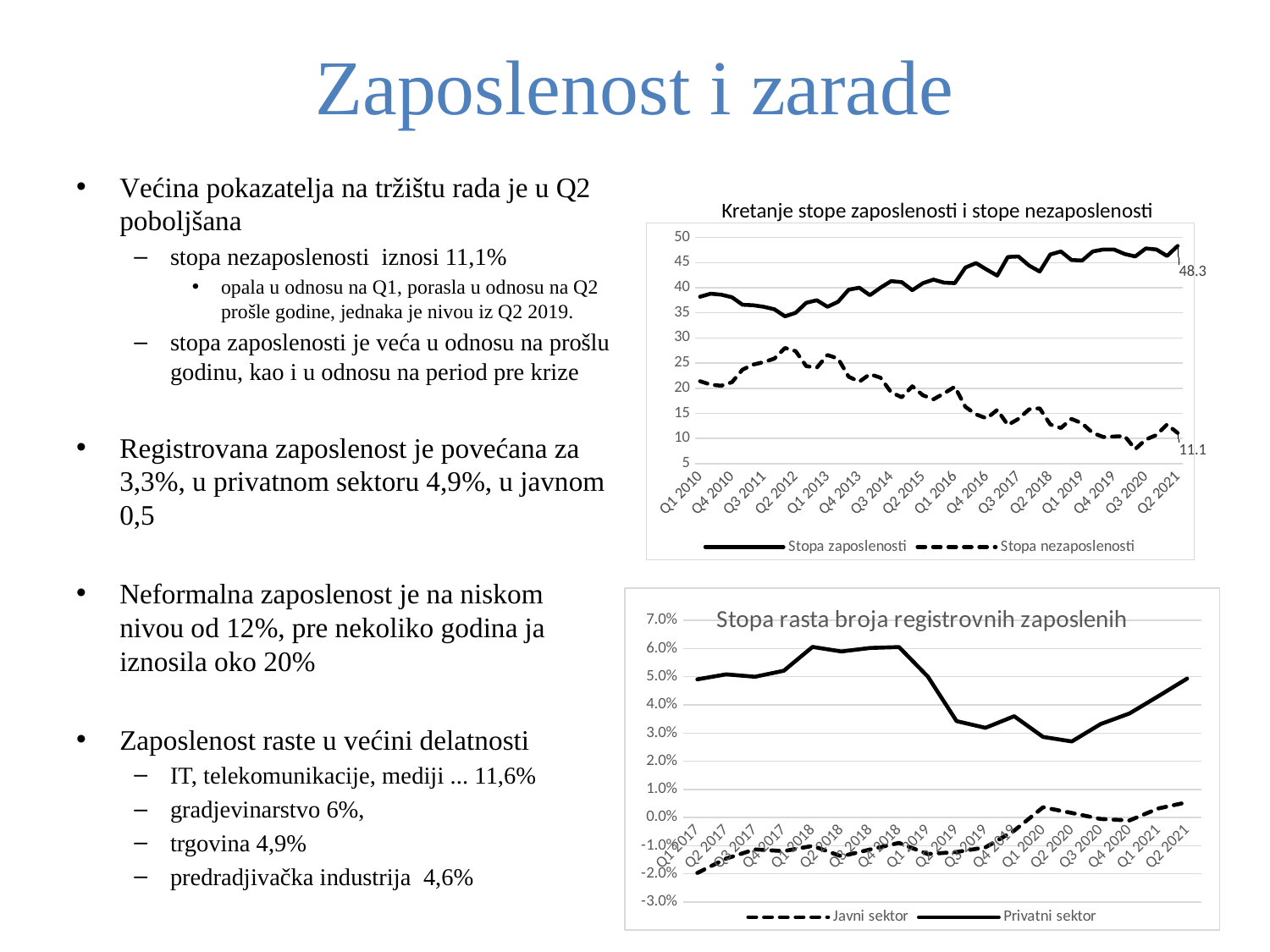
In the top chart "Kretanje stope zaposlenosti i stope nezaposlenosti", does Stopa nezaposlenosti rise or fall overall from Q1 2010 to Q2 2021? fall How many series does the legend of the bottom chart "Stopa rasta broja registrovnih zaposlenih" list? 2 What kind of chart is the bottom chart titled "Stopa rasta broja registrovnih zaposlenih"? line chart What kind of chart is the top chart titled "Kretanje stope zaposlenosti i stope nezaposlenosti"? line chart In the top chart "Kretanje stope zaposlenosti i stope nezaposlenosti", what is the value of Stopa nezaposlenosti at Q2 2021? 11.1 How many series does the legend of the top chart "Kretanje stope zaposlenosti i stope nezaposlenosti" list? 2 In the top chart "Kretanje stope zaposlenosti i stope nezaposlenosti", what is the difference between Stopa zaposlenosti and Stopa nezaposlenosti at Q2 2021? 37.2 In the top chart "Kretanje stope zaposlenosti i stope nezaposlenosti", does Stopa zaposlenosti rise or fall overall from Q1 2010 to Q2 2021? rise In the bottom chart "Stopa rasta broja registrovnih zaposlenih", which series has the larger value at Q1 2017? Privatni sektor In the top chart "Kretanje stope zaposlenosti i stope nezaposlenosti", which series has the larger value at Q2 2021? Stopa zaposlenosti In the bottom chart "Stopa rasta broja registrovnih zaposlenih", is the value for Privatni sektor at Q2 2021 greater or less than 4.0%? greater In the top chart "Kretanje stope zaposlenosti i stope nezaposlenosti", what is the value of Stopa zaposlenosti at Q2 2021? 48.3